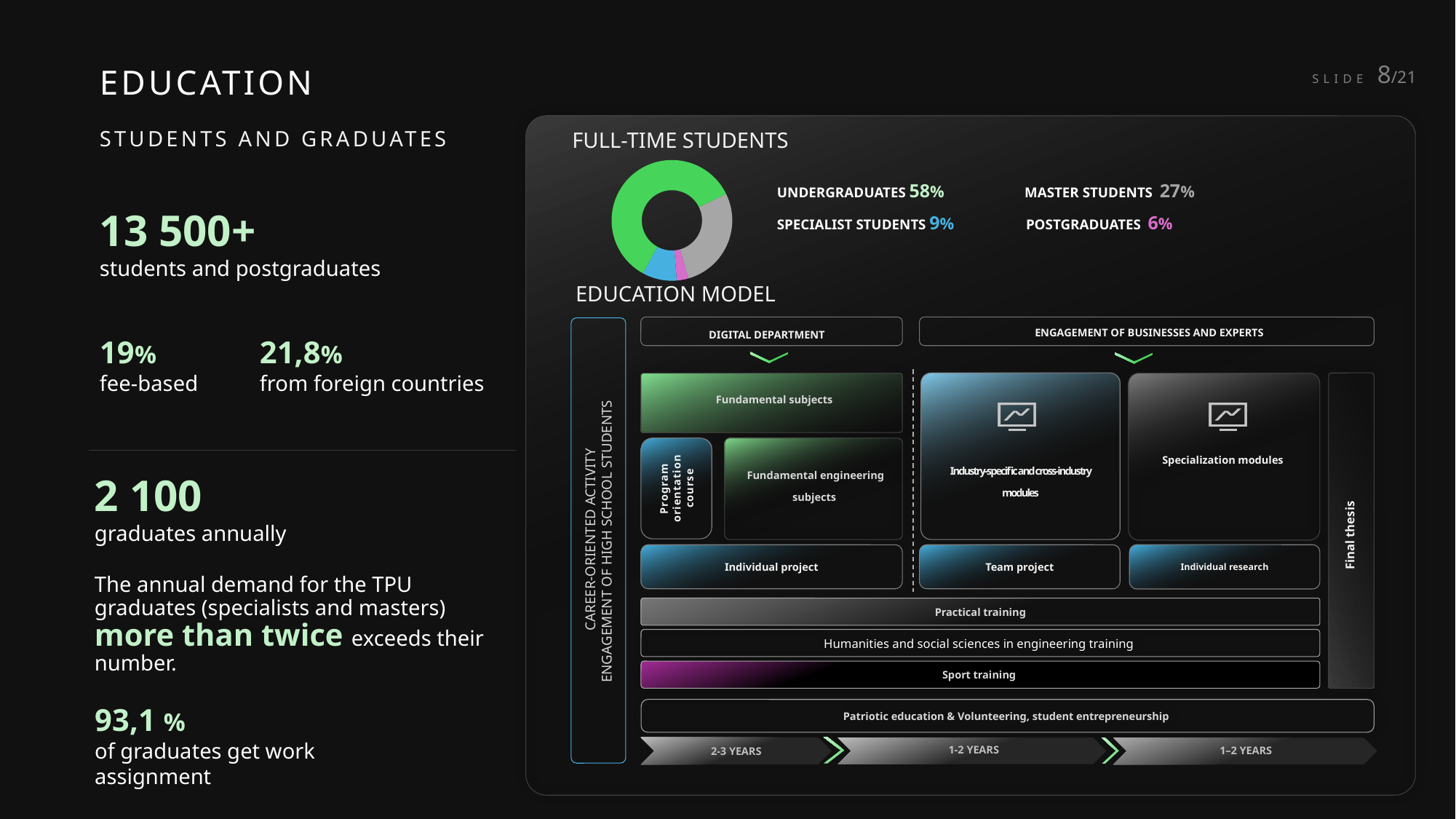
What colour represents undergraduates in the full-time students chart? Green Which category has the largest share in the full-time students chart? Undergraduates What share of full-time students are master students? 27% Which is larger in the full-time students chart: the share of master students or the share of specialist students? Master students Which category has the smallest share in the full-time students chart? Postgraduates What share of full-time students are specialist students? 9% What is the difference in percentage points between undergraduates and master students in the full-time students chart? 31 What is the difference in percentage points between specialist students and postgraduates? 3 What share of full-time students are undergraduates according to the donut chart? 58% What share of full-time students are postgraduates? 6% What kind of chart is used to show the full-time students breakdown? Donut (pie) chart How many categories does the full-time students chart show? 4